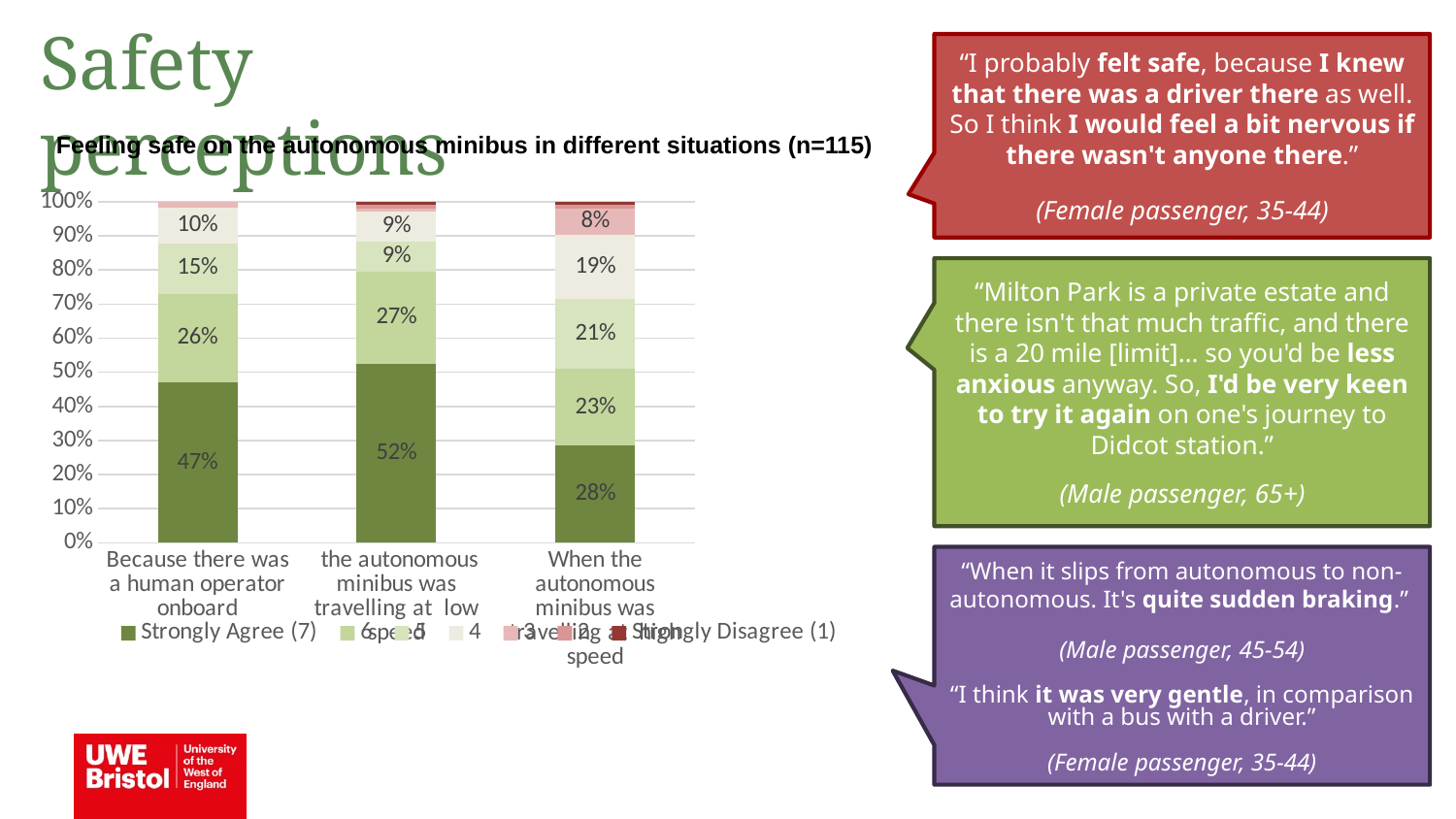
What is the title of the chart? Feeling safe on the autonomous minibus in different situations (n=115) What percentage of respondents strongly agreed (7) that they felt safe because there was a human operator onboard? 47% What is the sample size (n) stated in the chart title? 115 Which situation has the highest share of 'Strongly Agree (7)' responses? the autonomous minibus was travelling at low speed What type of chart is shown on the slide? Stacked bar chart What percentage of respondents strongly agreed (7) that they felt safe when the autonomous minibus was travelling at high speed? 28% Which is larger: the 'Strongly Agree (7)' share for the human operator onboard situation or for the high speed situation? Because there was a human operator onboard What is the difference in 'Strongly Agree (7)' share between the low speed situation and the high speed situation? 24% What percentage of respondents strongly agreed (7) that they felt safe when the autonomous minibus was travelling at low speed? 52% Is the 'Strongly Agree (7)' share for the human operator onboard situation greater or less than 40%? greater Which situation has the lowest share of 'Strongly Agree (7)' responses? When the autonomous minibus was travelling at high speed How many situations (categories) are shown on the x axis of the chart? 3